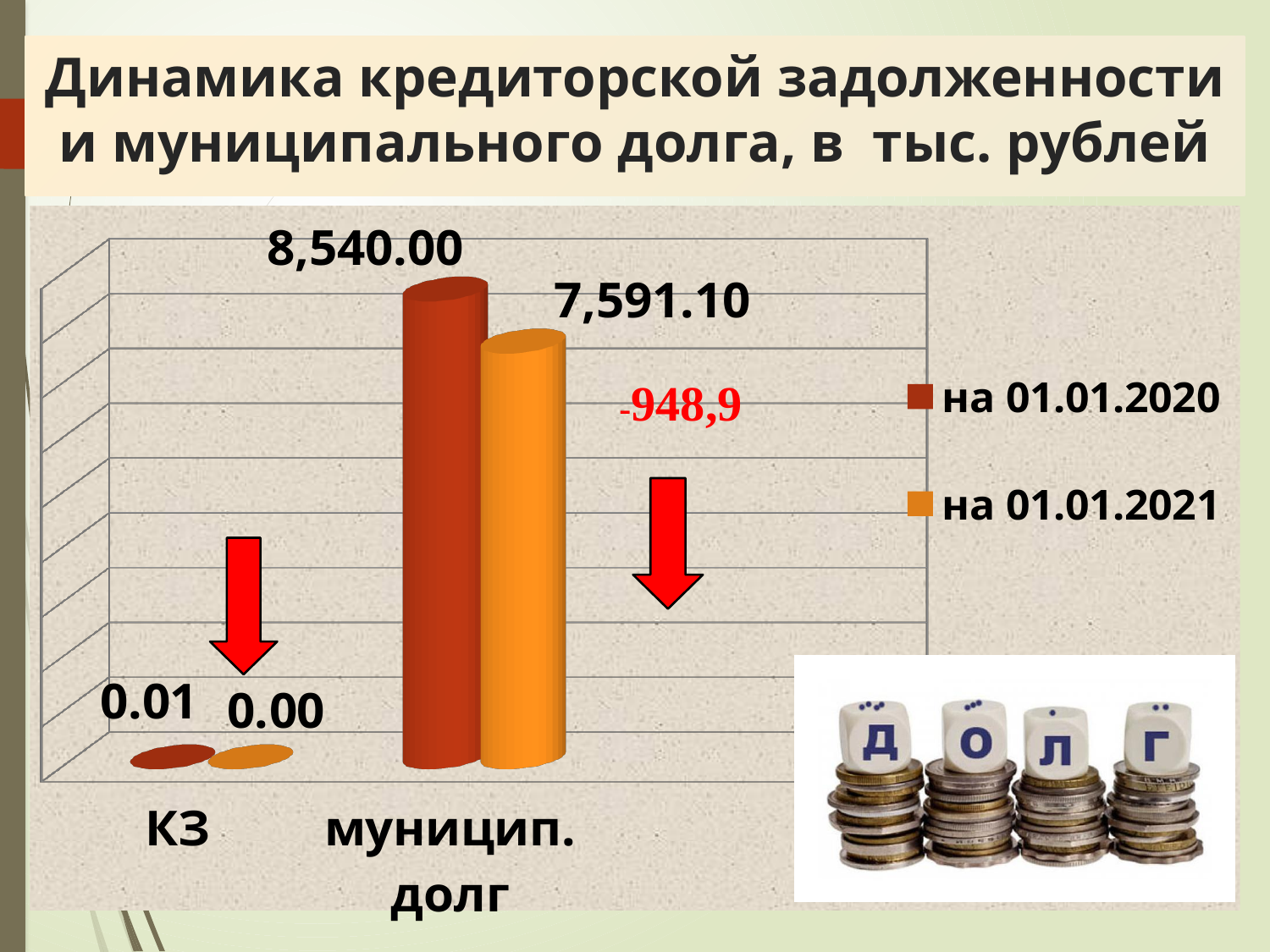
What is the value for КЗ in the series на 01.01.2020? 0.01 What is the difference between the муницип. долг values for на 01.01.2020 and на 01.01.2021? 948.90 What is the value for муницип. долг in the series на 01.01.2021? 7,591.10 Which category has the lowest value in the series на 01.01.2021? КЗ What kind of chart is shown on the slide? bar chart Which category has the highest value in the series на 01.01.2020? муницип. долг For муницип. долг, which is larger: the value for на 01.01.2020 or for на 01.01.2021? на 01.01.2020 How many categories are shown on the x axis of the chart? 2 What is the value for муницип. долг in the series на 01.01.2020? 8,540.00 How many series does the legend list? 2 What is the title of the slide? Динамика кредиторской задолженности и муниципального долга, в тыс. рублей What is the value for КЗ in the series на 01.01.2021? 0.00